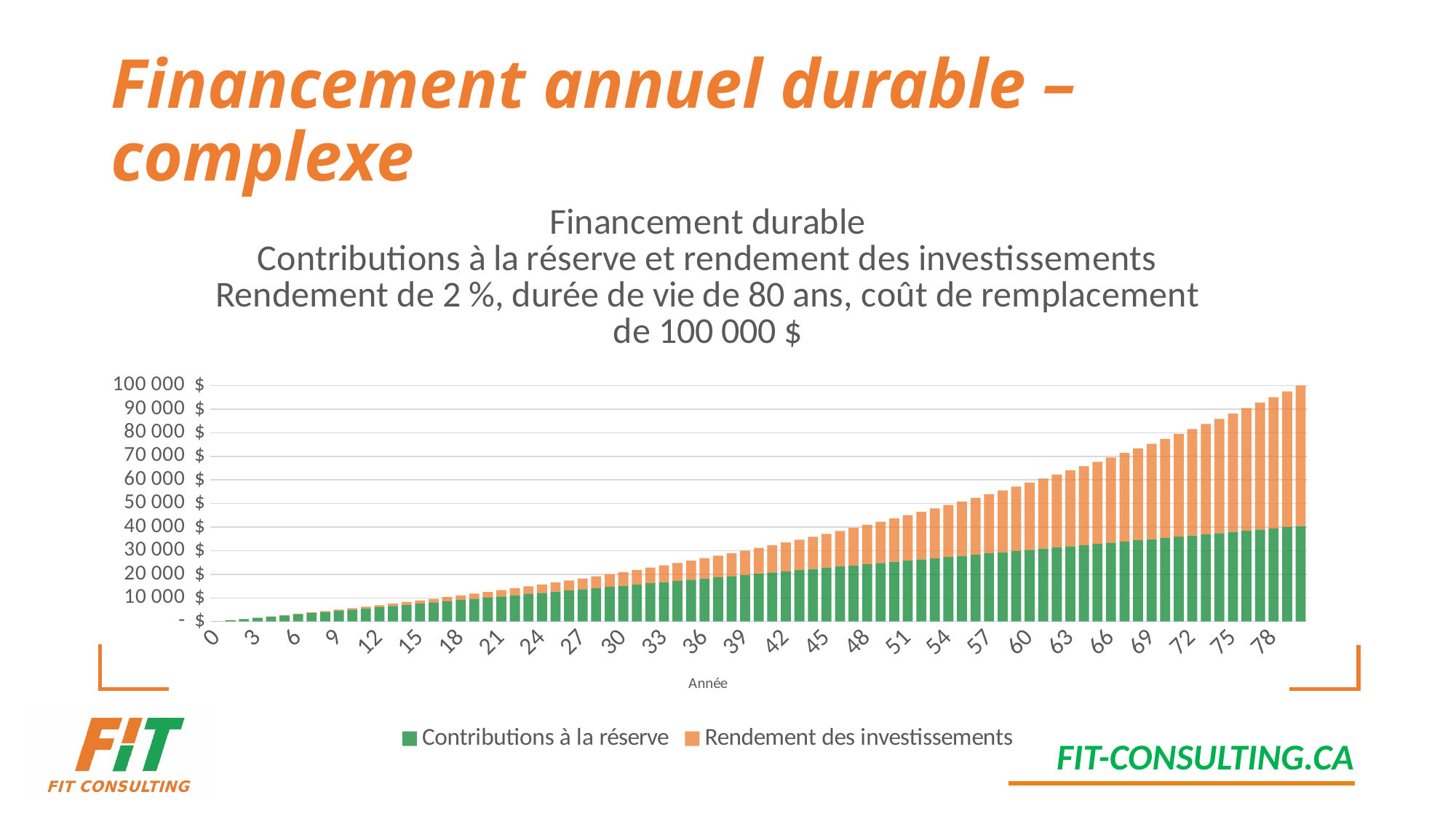
At year 78, which series has the larger value: Contributions à la réserve or Rendement des investissements? Rendement des investissements Is the value of Rendement des investissements at year 78 greater or less than 50 000 $? greater Is the value of Contributions à la réserve at year 78 greater or less than 50 000 $? less What kind of chart is shown on the slide? Stacked bar chart What is the label of the x axis of the chart? Année Is the total value of the bar at year 12 greater or less than 10 000 $? less What are the two series named in the chart legend? Contributions à la réserve; Rendement des investissements Do the total bar heights rise or fall as the year increases along the x axis? Rise How many series does the chart legend list? 2 At year 12, which series has the larger value: Contributions à la réserve or Rendement des investissements? Contributions à la réserve